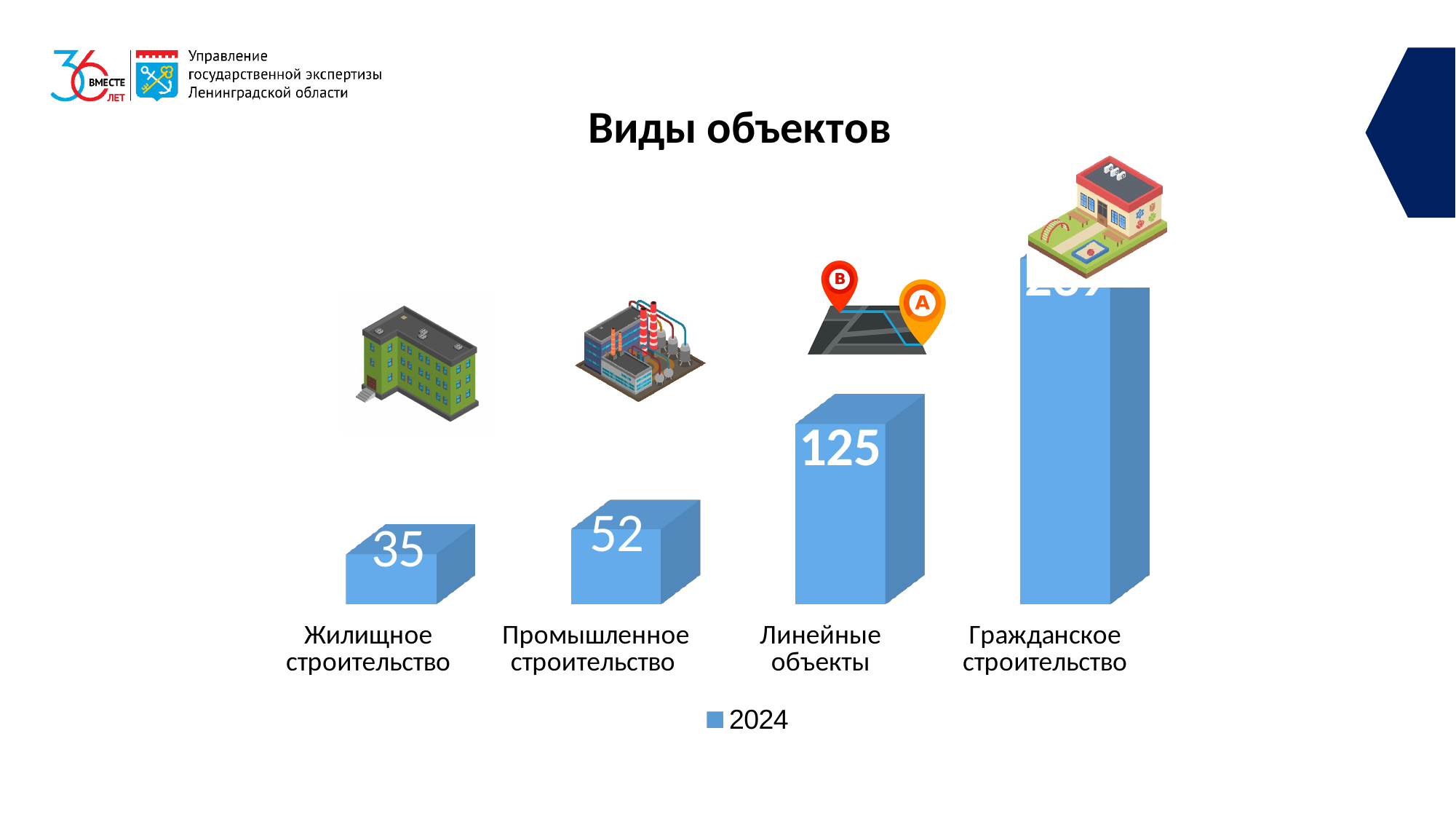
What is the value for Жилищное строительство? 35 What type of chart is shown on the slide? bar chart Which category has the lowest value? Жилищное строительство What is the value for Промышленное строительство? 52 How many categories are shown in the chart? 4 Which is larger, the value for Линейные объекты or the value for Жилищное строительство? Линейные объекты Which category has the highest value? Гражданское строительство How many series does the legend list? 1 What is the value for Линейные объекты? 125 What is the difference between the values for Линейные объекты and Промышленное строительство? 73 What is the difference between the values for Промышленное строительство and Жилищное строительство? 17 What is the title of the chart? Виды объектов